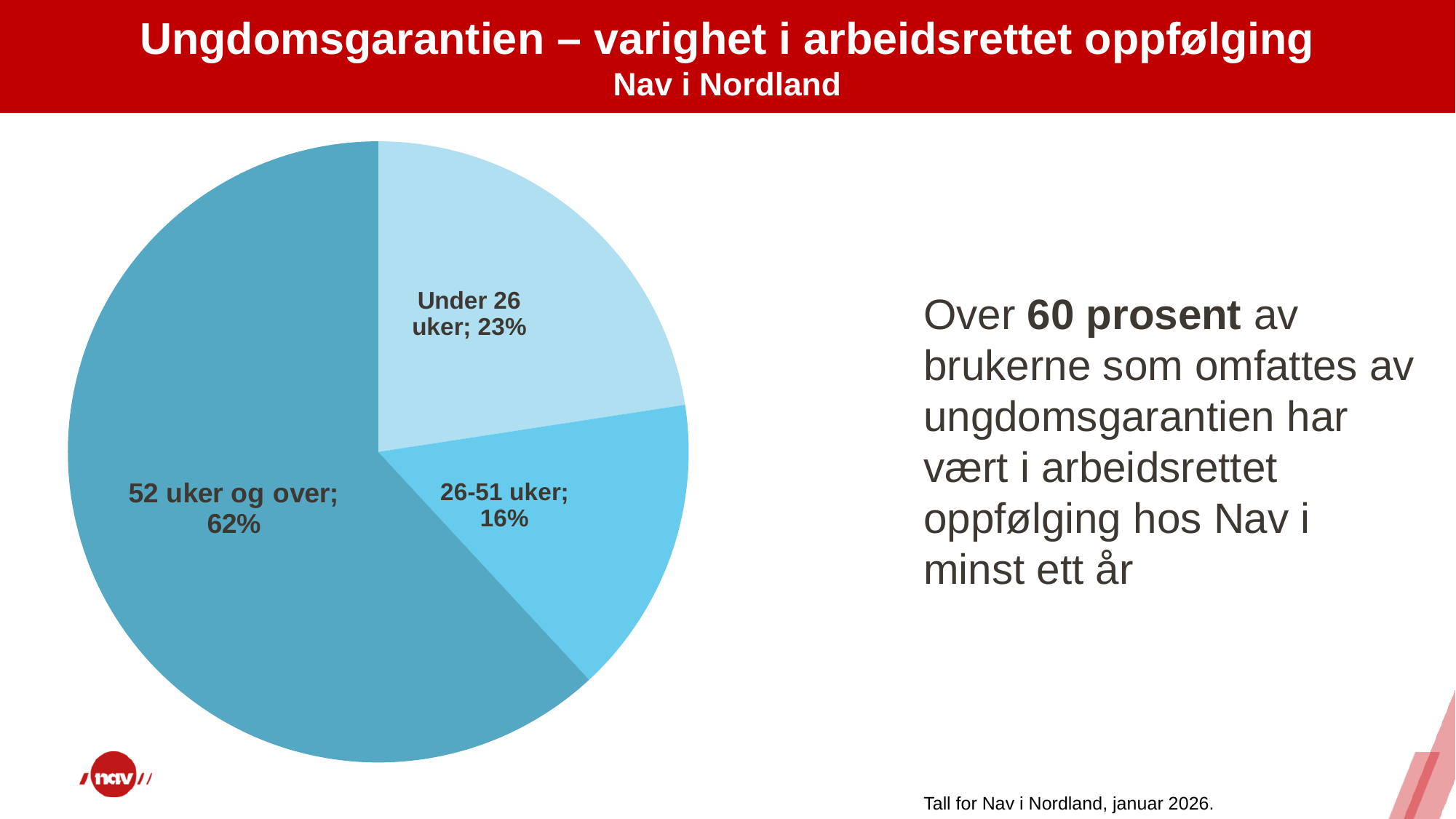
Which slice of the pie is the darkest blue? 52 uker og over What is the difference in percentage points between '52 uker og over' and 'Under 26 uker'? 39 What is the difference in percentage points between 'Under 26 uker' and '26-51 uker'? 7 What kind of chart is shown on the slide? pie chart What is the value shown for '26-51 uker'? 16% What is the value shown for 'Under 26 uker'? 23% What share of the pie does '52 uker og over' represent? 62% Which category has the largest slice of the pie? 52 uker og over Is the value for '52 uker og over' greater or less than 50%? greater Which category has the smallest slice of the pie? 26-51 uker Which is larger, the slice for 'Under 26 uker' or the slice for '26-51 uker'? Under 26 uker How many slices does the pie chart have? 3